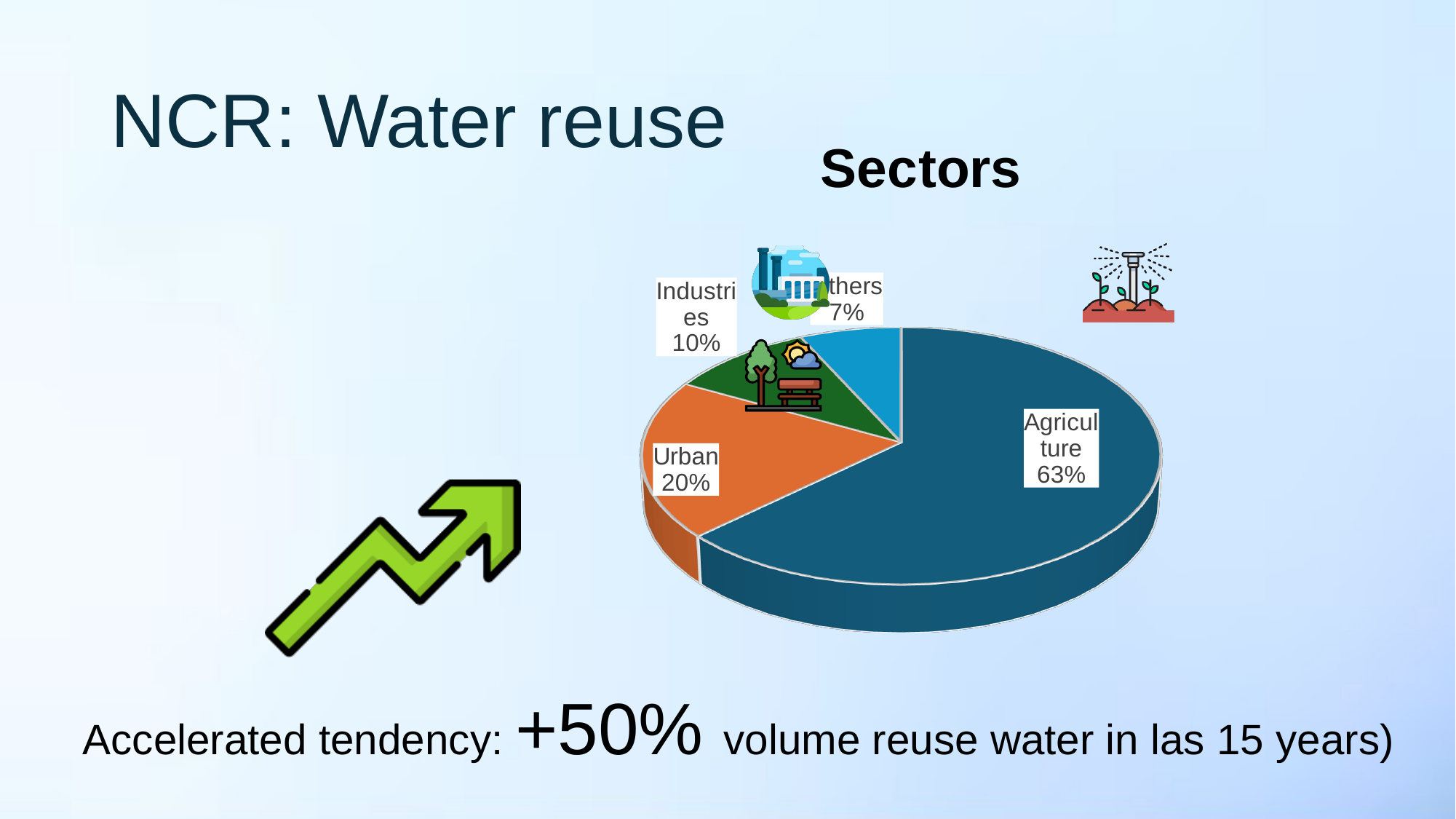
What share of the pie does Agriculture have? 63% What kind of chart is shown under the title "Sectors"? pie chart Which sector has the smallest slice of the pie? Others What share of the pie does Industries have? 10% What is the difference in percentage points between Agriculture and Urban? 43 What share of the pie does Others have? 7% What colour is the Agriculture slice? dark blue What share of the pie does Urban have? 20% How many slices does the pie chart have? 4 What is the title of the chart? Sectors Which sector has the largest slice of the pie? Agriculture Which is larger, the Urban slice or the Industries slice? Urban